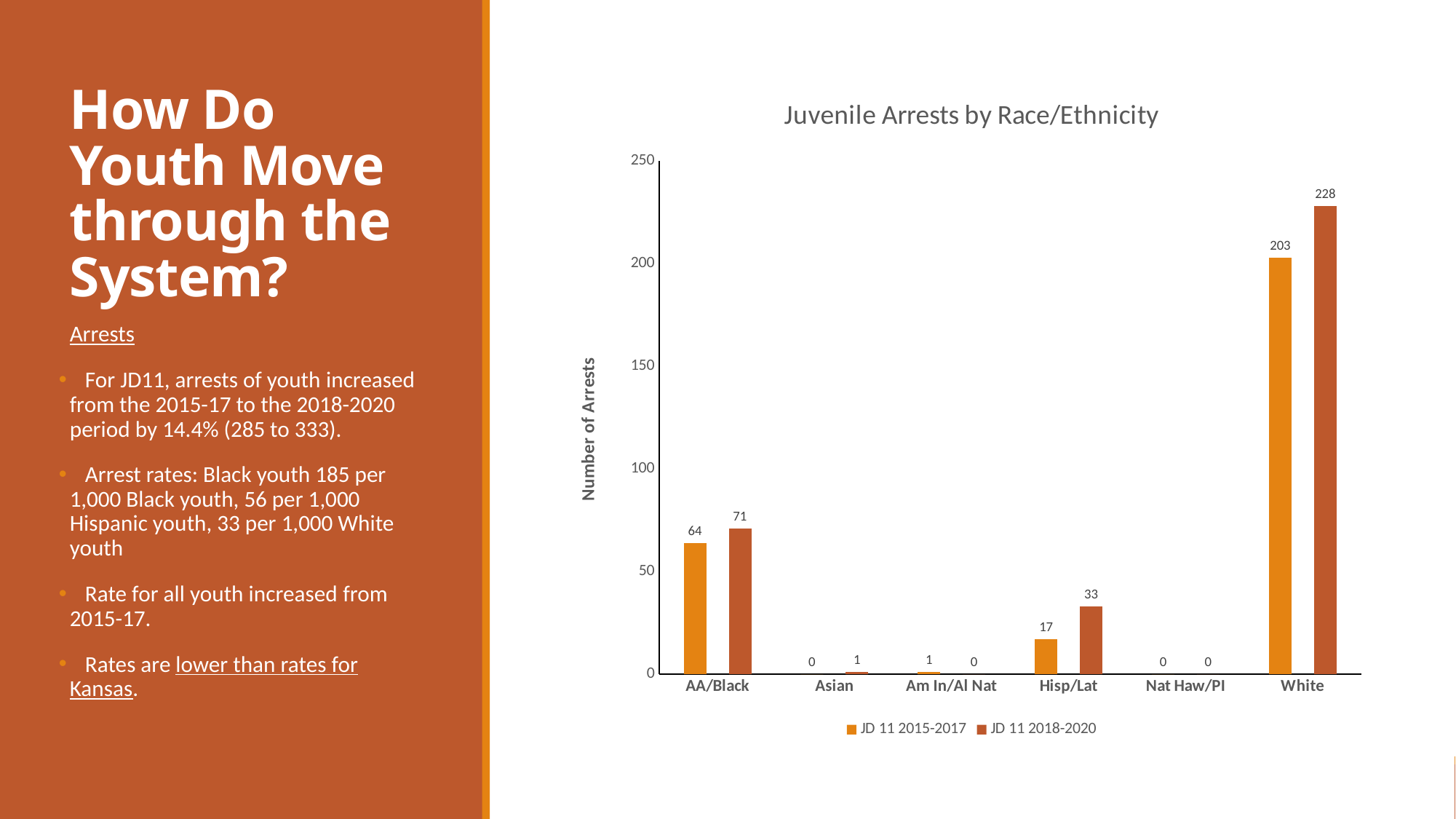
Is the value for White youth in JD 11 2015-2017 greater or less than 200? greater How many series does the legend list? 2 Which race/ethnicity category has the highest number of arrests in JD 11 2015-2017? White How many race/ethnicity categories are shown on the x axis? 6 What is the title of the chart? Juvenile Arrests by Race/Ethnicity What is the difference in arrests for White youth between JD 11 2018-2020 and JD 11 2015-2017? 25 Which is larger for Hisp/Lat youth: arrests in JD 11 2015-2017 or JD 11 2018-2020? JD 11 2018-2020 What is the number of arrests for White youth in JD 11 2018-2020? 228 What is the number of arrests for AA/Black youth in JD 11 2015-2017? 64 What is the difference in arrests for AA/Black youth between JD 11 2018-2020 and JD 11 2015-2017? 7 What kind of chart is shown on the slide? Bar chart What is the number of arrests for Hisp/Lat youth in JD 11 2018-2020? 33